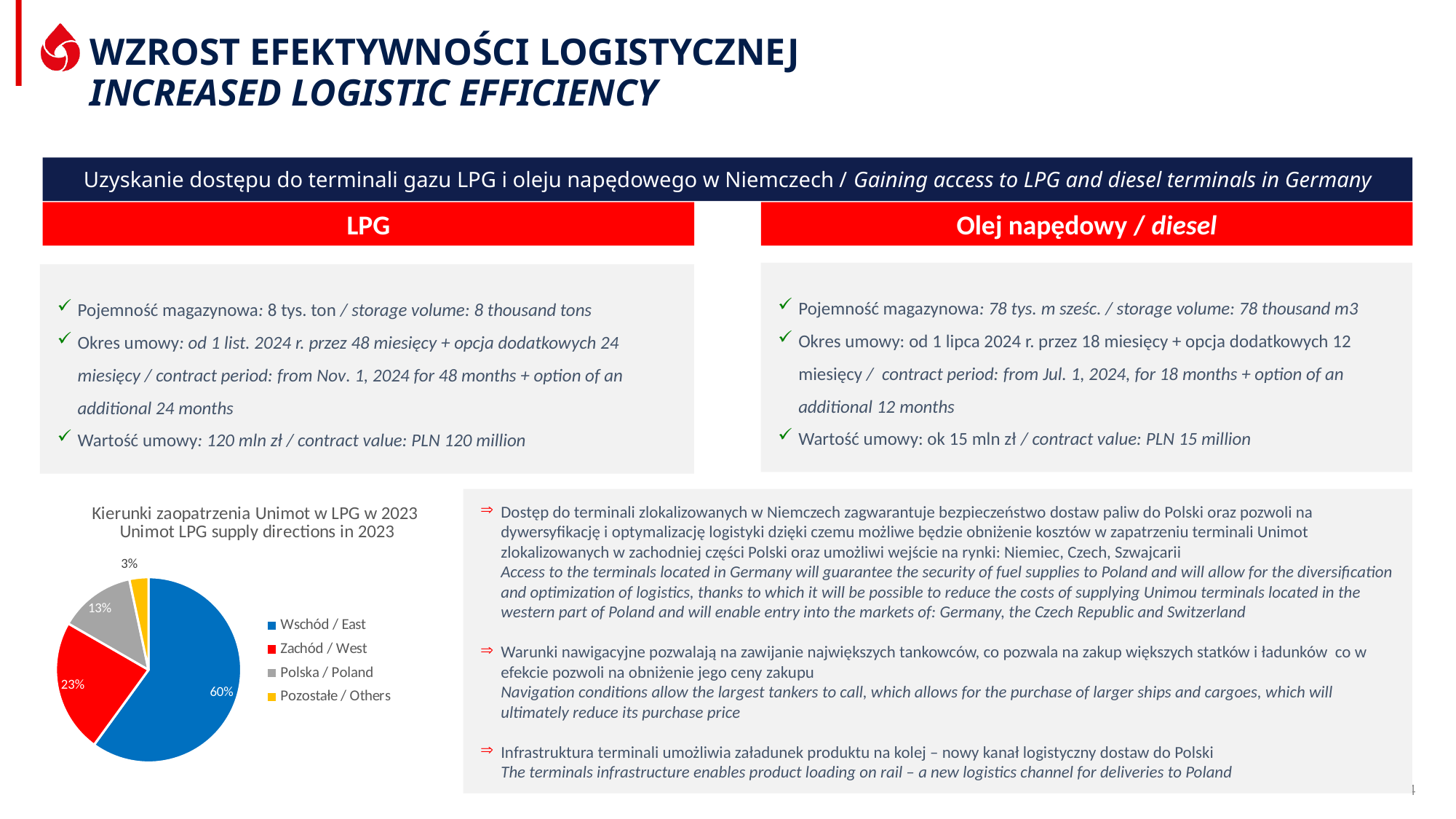
Which is larger, the share for Zachód / West or for Polska / Poland? Zachód / West How many categories does the pie chart show? 4 Which supply direction has the largest share in the pie chart? Wschód / East What is the difference in percentage points between the Wschód / East and Zachód / West shares? 37 percentage points What share of Unimot's LPG supply in 2023 came from Zachód / West? 23% What share of Unimot's LPG supply in 2023 came from Wschód / East? 60% What is the title of the pie chart? Kierunki zaopatrzenia Unimot w LPG w 2023 / Unimot LPG supply directions in 2023 What share of Unimot's LPG supply in 2023 came from Polska / Poland? 13% What share of Unimot's LPG supply in 2023 came from Pozostałe / Others? 3% Which supply direction has the smallest share in the pie chart? Pozostałe / Others What colour is the Polska / Poland slice in the pie chart? Grey What kind of chart is shown on the slide? Pie chart